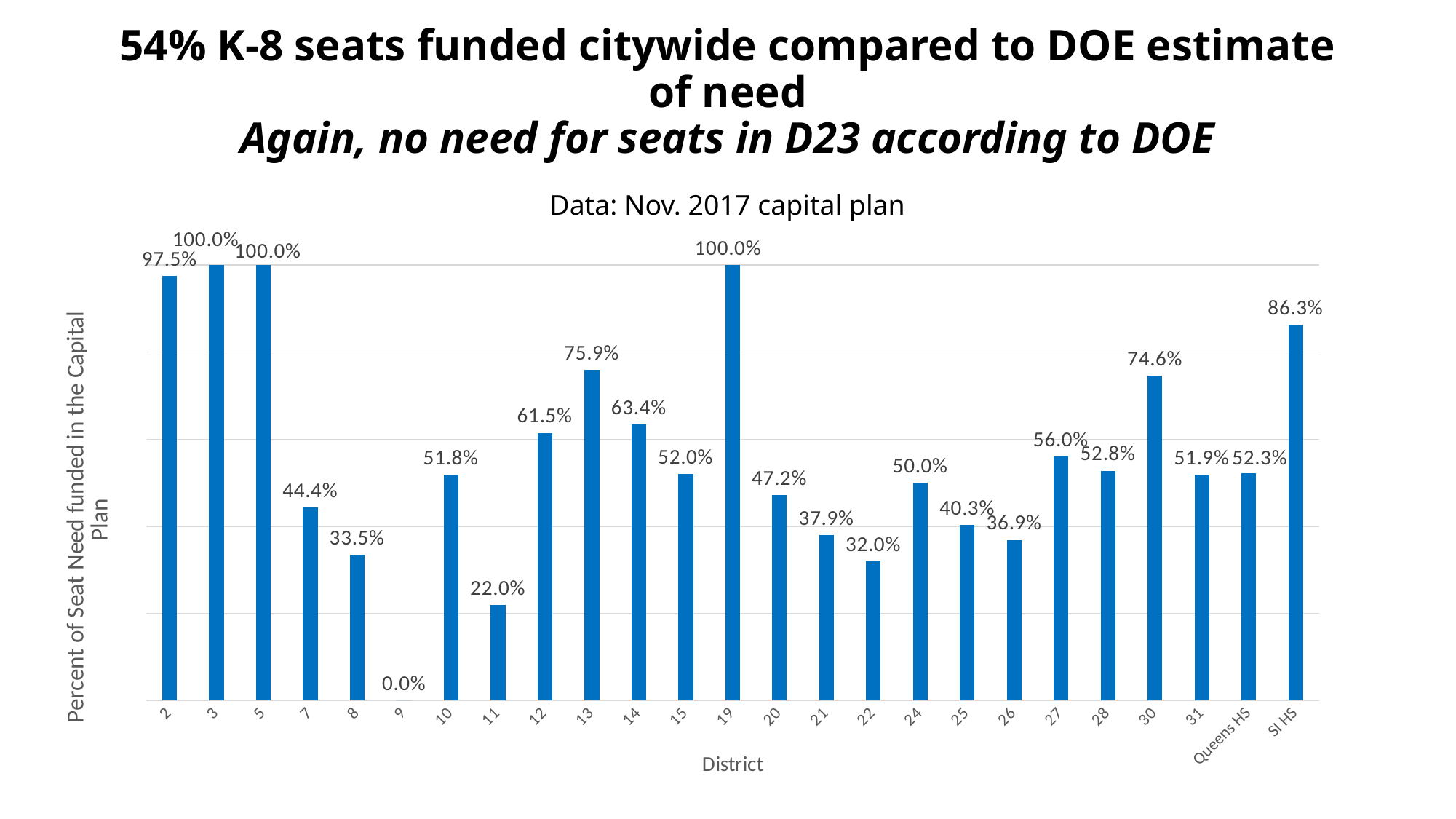
What is the value for District 11? 22.0% Which district has the lowest value? 9 What is the value for Queens HS? 52.3% Which is larger, the value for District 22 or the value for District 25? District 25 How many categories are shown on the x axis? 25 What is the title of the chart? Data: Nov. 2017 capital plan Which is larger, the value for District 12 or the value for District 14? District 14 What is the value for SI HS? 86.3% What is the difference between the values for District 2 and District 8? 64.0% What is the value for District 13? 75.9% What is the difference between the values for District 30 and District 31? 22.7% What kind of chart is shown on the slide? Bar chart